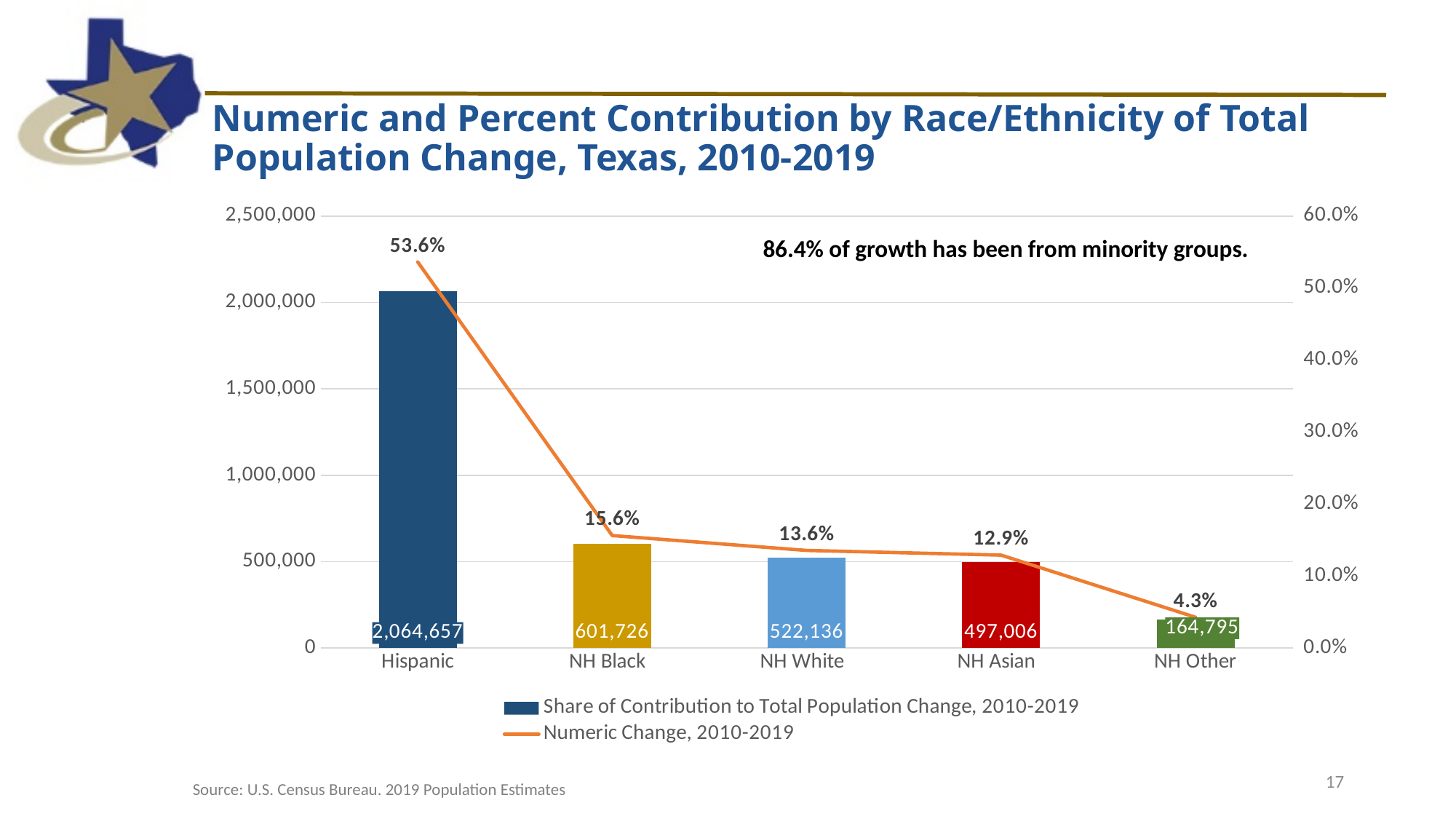
Which race/ethnicity category has the shortest bar? NH Other What is the difference between the percentage labels for Hispanic and NH Black? 38.0% What is the value shown on the bar for NH Asian? 497,006 What percentage label is shown above the NH Other bar? 4.3% How many series does the legend list? 2 What is the difference between the bar values for NH Black and NH White? 79,590 Do the bar values rise or fall moving from left to right along the x axis? fall What is the value shown on the bar for Hispanic? 2,064,657 Which race/ethnicity category has the tallest bar? Hispanic Which has a larger bar value, NH White or NH Asian? NH White What percentage label is shown above the NH Black bar? 15.6% How many race/ethnicity categories are shown on the x axis? 5